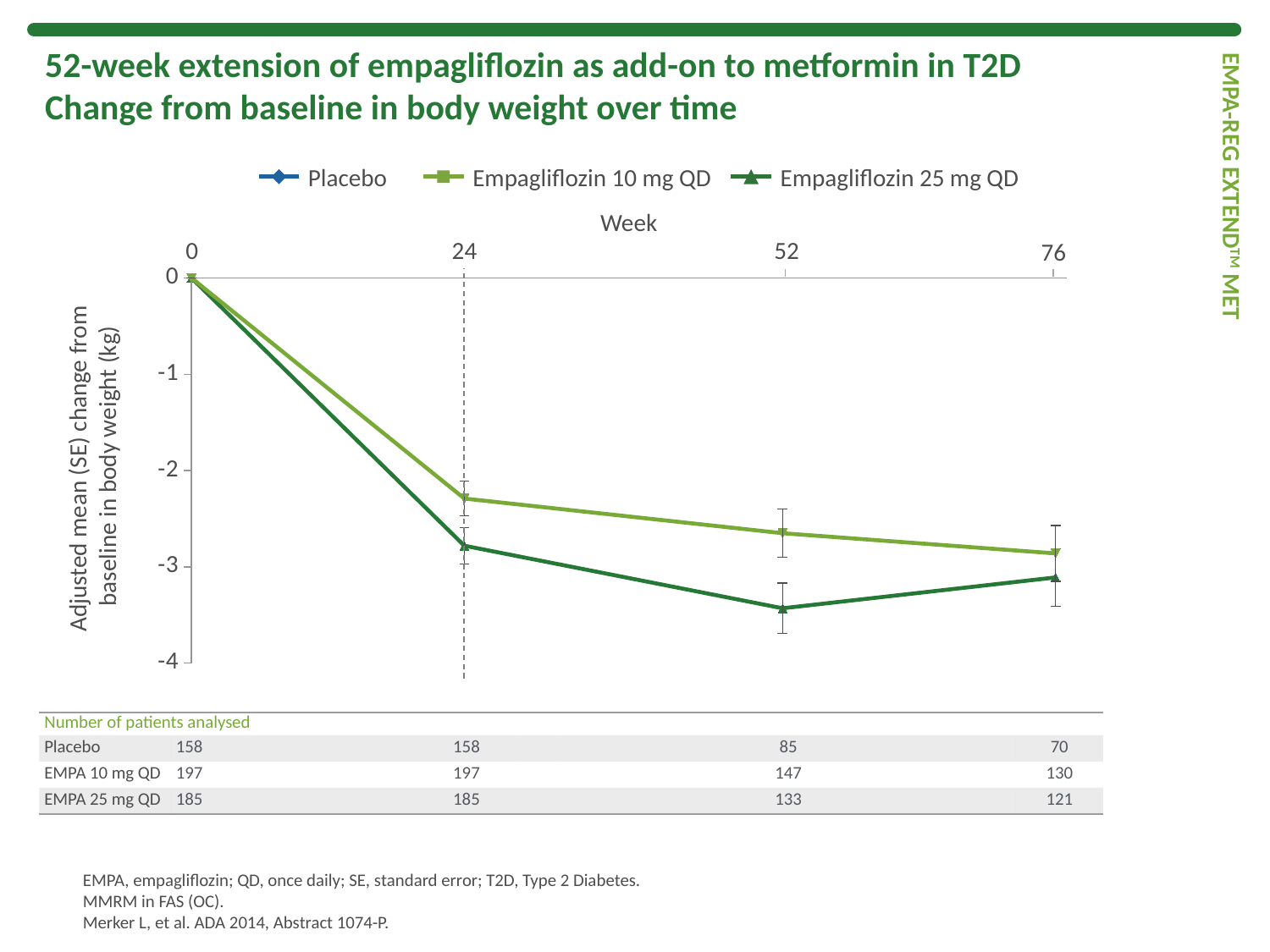
How many week time points are marked on the x axis? 4 How many series does the legend list? 3 What is the label of the y axis? Adjusted mean (SE) change from baseline in body weight (kg) According to the number of patients analysed table, how many Placebo patients were analysed at week 52? 85 Is the value for Empagliflozin 25 mg QD at week 52 greater or less than -3? less Does the Empagliflozin 10 mg QD line rise or fall from week 0 to week 76? fall At week 52, which series shows the larger reduction in body weight, Empagliflozin 10 mg QD or Empagliflozin 25 mg QD? Empagliflozin 25 mg QD What kind of chart is shown on the slide? line chart According to the number of patients analysed table, how many EMPA 25 mg QD patients were analysed at week 76? 121 Is the value for Empagliflozin 10 mg QD at week 52 greater or less than -3? greater Is the value for Empagliflozin 10 mg QD at week 24 greater or less than -2? less What is the change from baseline in body weight for Empagliflozin 25 mg QD at week 0? 0